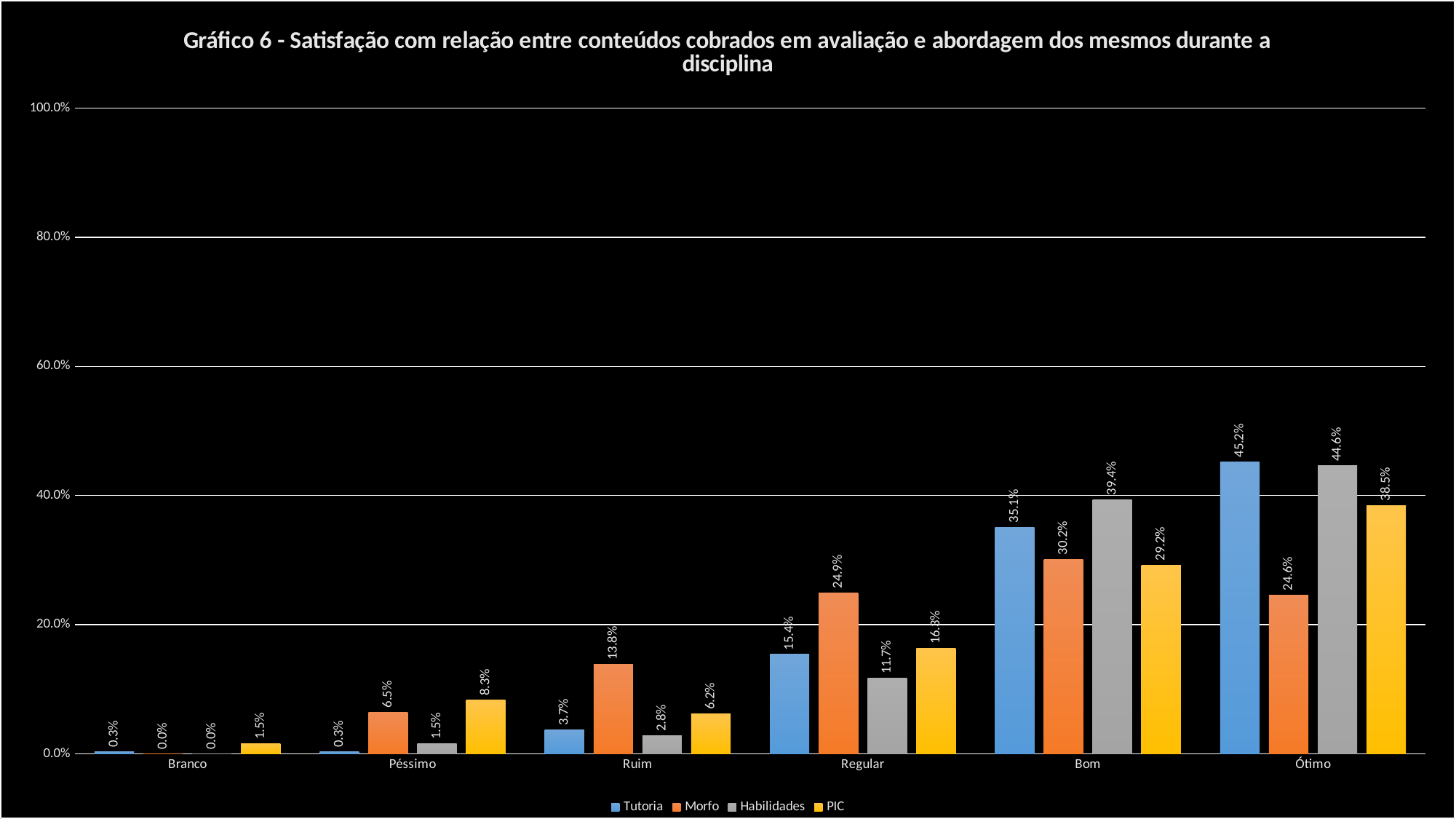
What is the value for Habilidades in the Bom category? 39.4% What is the value for Tutoria in the Ótimo category? 45.2% How many series does the legend list? 4 Which category has the highest value for the Morfo series? Bom What is the difference between the Tutoria and Morfo values in the Ótimo category? 20.6% Which series has the lowest value in the Ótimo category? Morfo How many categories are shown on the x axis? 6 What is the value for Morfo in the Regular category? 24.9% What kind of chart is shown on the slide? Bar chart Which series is shown in yellow in the legend? PIC What is the value for PIC in the Péssimo category? 8.3% In the Ruim category, which is larger: the Morfo value or the PIC value? Morfo